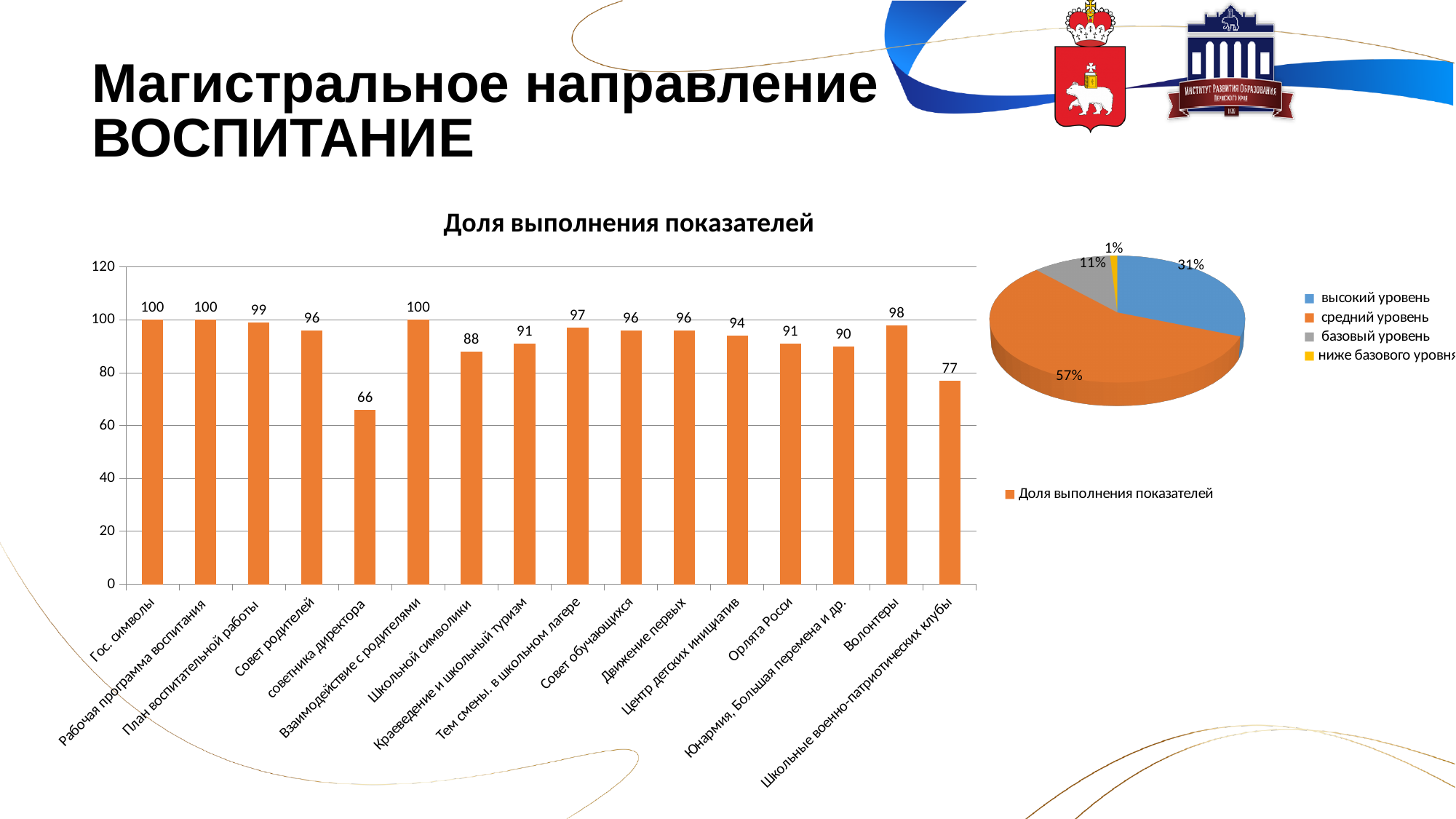
In the pie chart on the right, what share does 'средний уровень' have? 57% In the pie chart on the right, what share does 'ниже базового уровня' have? 1% In the bar chart 'Доля выполнения показателей', what is the value for 'советника директора'? 66 In the bar chart 'Доля выполнения показателей', which is larger: the value for 'Школьной символики' or the value for 'Центр детских инициатив'? Центр детских инициатив In the bar chart 'Доля выполнения показателей', what is the difference between the values for 'Школьные военно-патриотические клубы' and 'советника директора'? 11 In the bar chart 'Доля выполнения показателей', how many categories are shown on the x axis? 16 How many entries does the legend of the pie chart on the right list? 4 In the pie chart on the right, which category has the largest slice? средний уровень In the bar chart 'Доля выполнения показателей', which category has the lowest value? советника директора In the bar chart 'Доля выполнения показателей', what is the value for 'Волонтеры'? 98 In the bar chart 'Доля выполнения показателей', what is the value for 'Юнармия, Большая перемена и др.'? 90 What kind of chart is the chart on the left titled 'Доля выполнения показателей'? bar chart